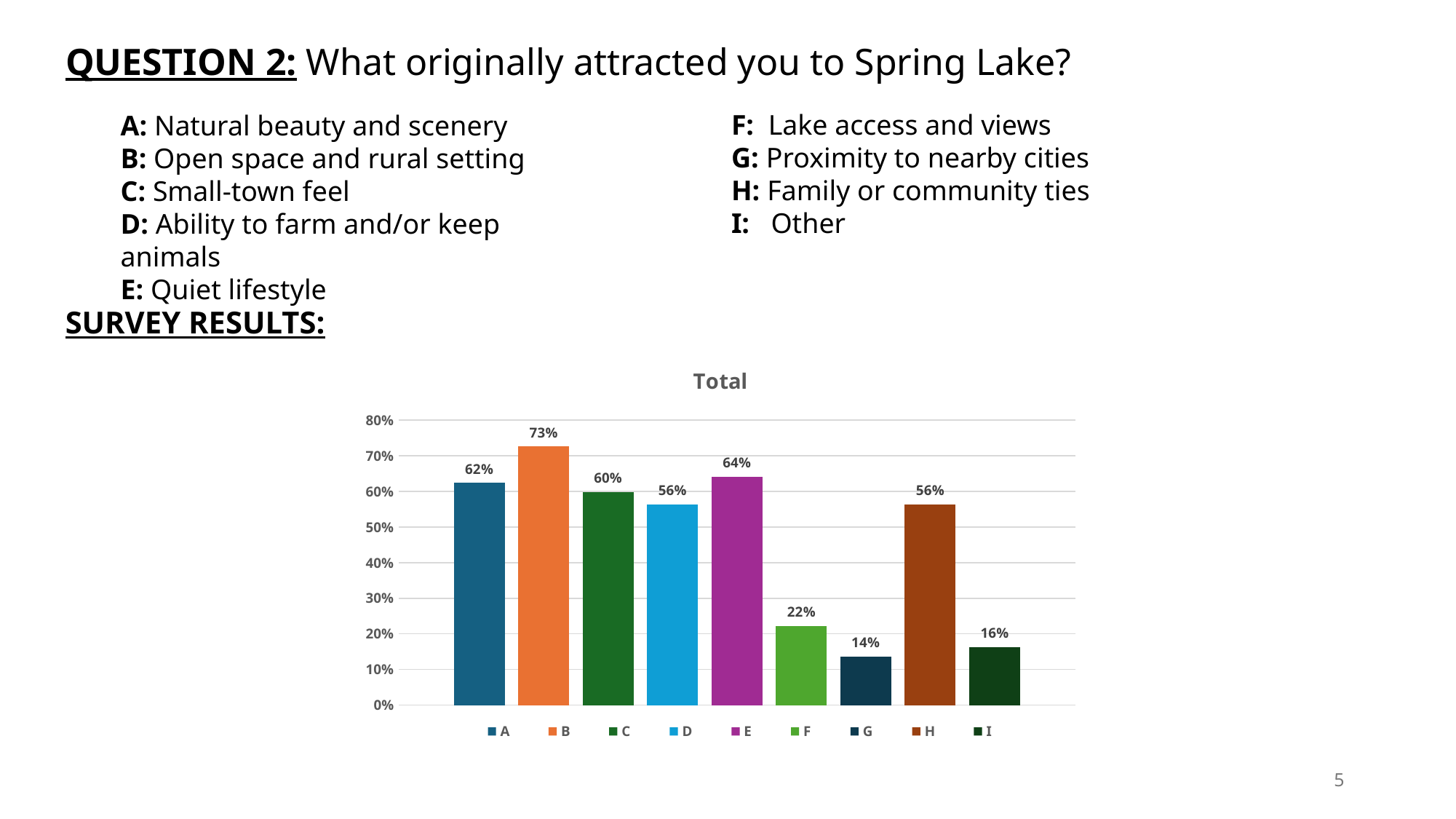
What kind of chart is shown on the slide? bar chart What is the difference between the values for B and A? 11% Is the value for G greater or less than 20%? less What is the value for category H? 56% What is the value for category F? 22% What is the value for category B? 73% What is the title of the chart? Total How many categories are shown in the chart? 9 Which is larger, the value for C or the value for E? E What is the difference between the values for E and I? 48% Which category has the highest value? B Which category has the lowest value? G